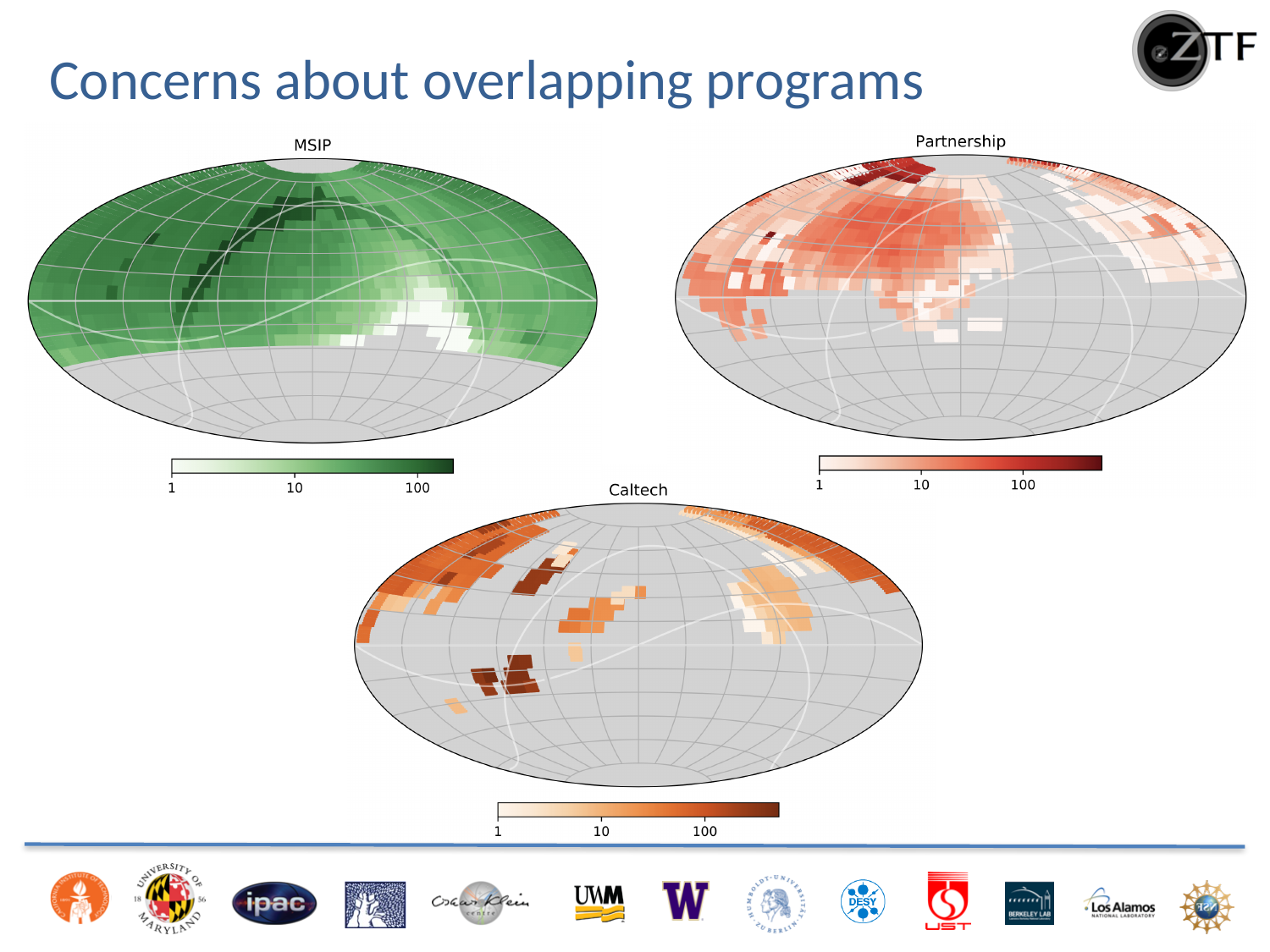
Which sky map is positioned at the bottom centre of the slide? Caltech What kind of chart is the MSIP panel? heat map (sky map) On the Partnership chart, what is the middle tick label on the colour bar? 10 On the MSIP chart, what is the highest tick label on the colour bar? 100 How many sky maps are shown on the slide? 3 On the Caltech chart, what is the lowest tick label on the colour bar? 1 What is the title of the green sky map? MSIP On the Partnership chart, how many tick labels are printed on the colour bar? 3